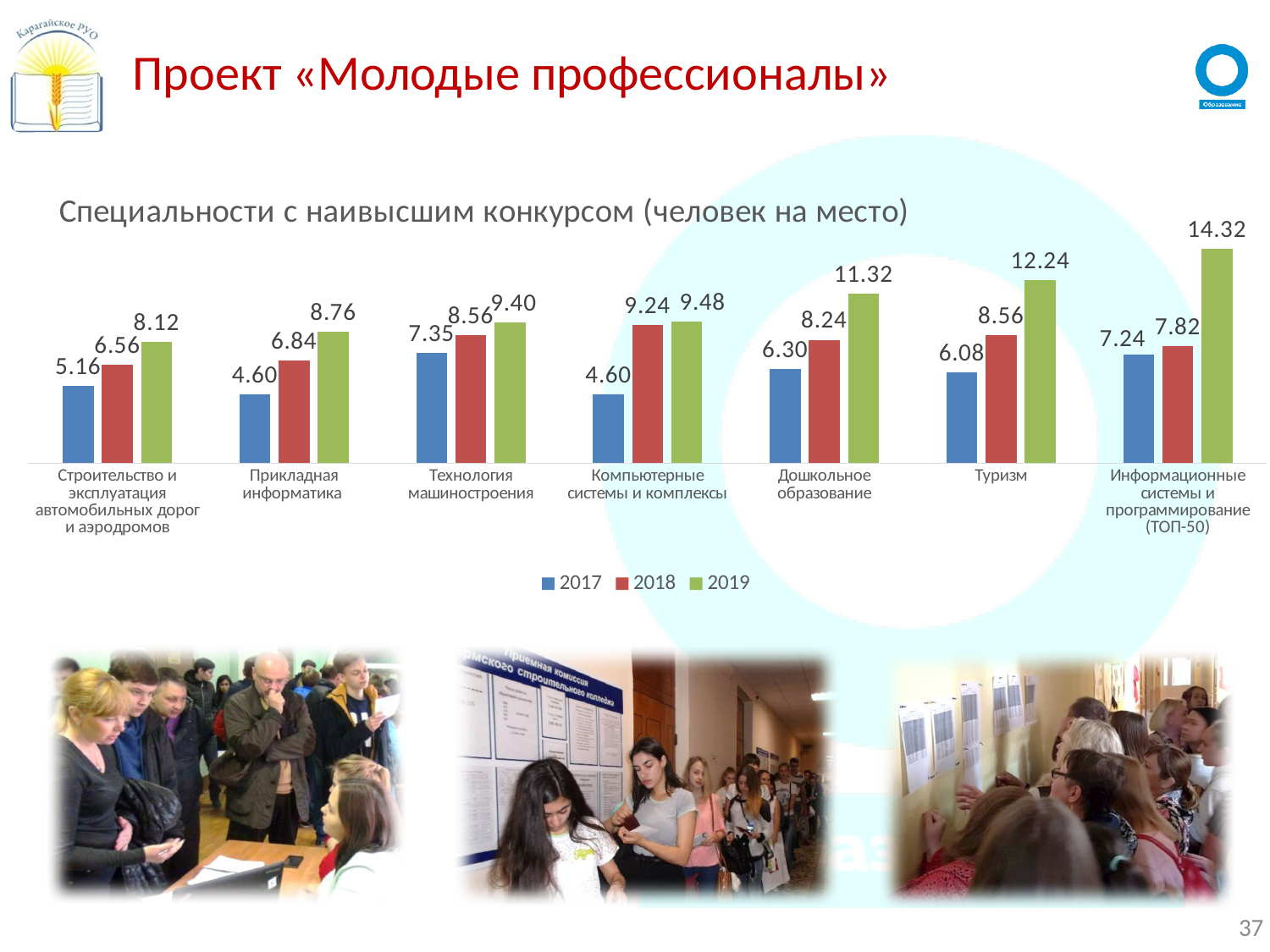
What is the 2018 value for Компьютерные системы и комплексы? 9.24 What is the title of the chart? Специальности с наивысшим конкурсом (человек на место) Which is larger: the 2018 value for Технология машиностроения or the 2018 value for Прикладная информатика? Технология машиностроения Which category has the lowest value in 2017? Прикладная информатика and Компьютерные системы и комплексы (both 4.60) How many series does the legend list? 3 How many categories (specialties) are shown on the chart? 7 What is the difference between the 2019 and 2017 values for Информационные системы и программирование (ТОП-50)? 7.08 What is the value for Туризм in 2019? 12.24 What is the value for Дошкольное образование in 2017? 6.30 Which category has the highest value in 2019? Информационные системы и программирование (ТОП-50) What kind of chart is shown on the slide? Bar chart For Туризм, do the values rise or fall from 2017 to 2019? Rise